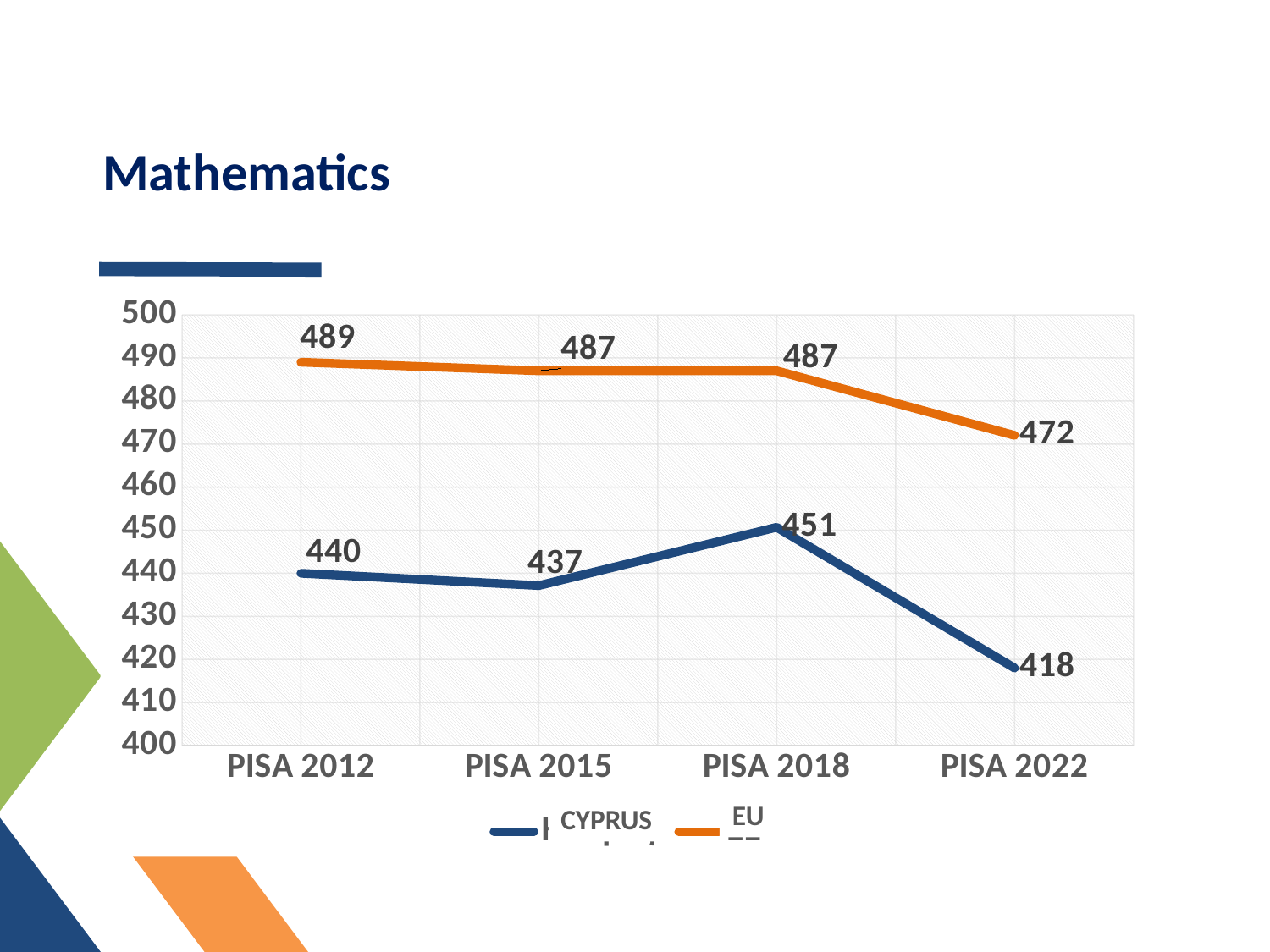
What kind of chart is shown on the slide? line chart What is the CYPRUS value for PISA 2018? 451 What is the CYPRUS value for PISA 2022? 418 In which PISA cycle is the EU value lowest? PISA 2022 Does the EU value rise or fall from PISA 2018 to PISA 2022? fall Which is larger for PISA 2015, the CYPRUS value or the EU value? EU What is the EU value for PISA 2012? 489 How many series does the legend list? 2 In which PISA cycle is the CYPRUS value highest? PISA 2018 What is the EU value for PISA 2022? 472 How many PISA cycles are shown on the x axis? 4 What is the difference between the EU and CYPRUS values for PISA 2022? 54